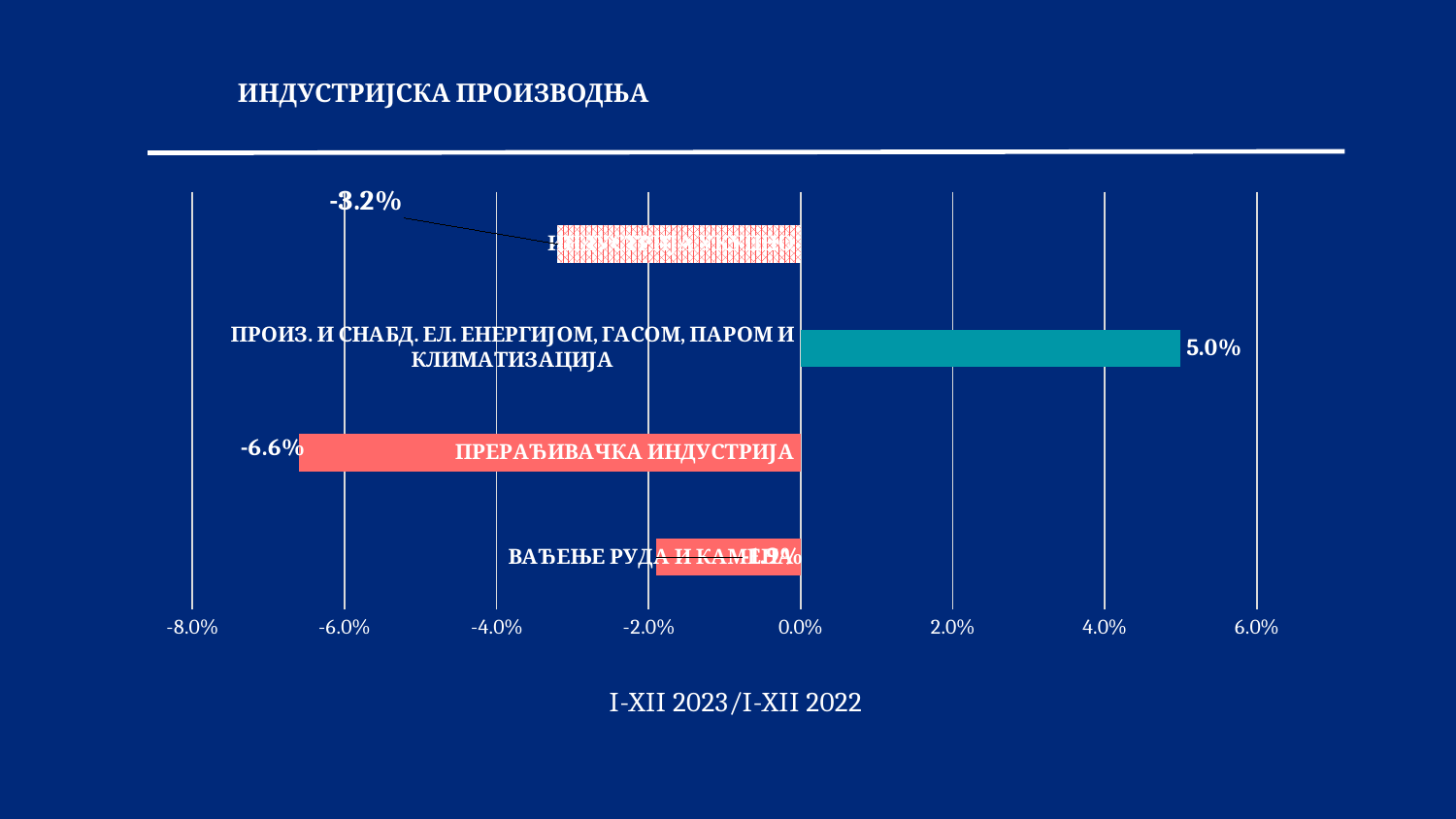
What is the value for ПРЕРАЂИВАЧКА ИНДУСТРИЈА? -6.6% How many bars are plotted in the chart? 4 Is the value for ВАЂЕЊЕ РУДА И КАМЕНА greater or less than 0.0%? less Which is larger, the value for ПРЕРАЂИВАЧКА ИНДУСТРИЈА or the value for ПРОИЗ. И СНАБД. ЕЛ. ЕНЕРГИЈОМ, ГАСОМ, ПАРОМ И КЛИМАТИЗАЦИЈА? ПРОИЗ. И СНАБД. ЕЛ. ЕНЕРГИЈОМ, ГАСОМ, ПАРОМ И КЛИМАТИЗАЦИЈА Is the value for ВАЂЕЊЕ РУДА И КАМЕНА greater or less than -4.0%? greater What kind of chart is shown on the slide? bar chart What is the title of the chart? I-XII 2023/I-XII 2022 What is the difference between the value for ПРОИЗ. И СНАБД. ЕЛ. ЕНЕРГИЈОМ, ГАСОМ, ПАРОМ И КЛИМАТИЗАЦИЈА and the value for ПРЕРАЂИВАЧКА ИНДУСТРИЈА? 11.6 percentage points Which category has the lowest value? ПРЕРАЂИВАЧКА ИНДУСТРИЈА What is the value for ПРОИЗ. И СНАБД. ЕЛ. ЕНЕРГИЈОМ, ГАСОМ, ПАРОМ И КЛИМАТИЗАЦИЈА? 5.0% Which category has the highest value? ПРОИЗ. И СНАБД. ЕЛ. ЕНЕРГИЈОМ, ГАСОМ, ПАРОМ И КЛИМАТИЗАЦИЈА How many bars in the chart have a positive value? 1